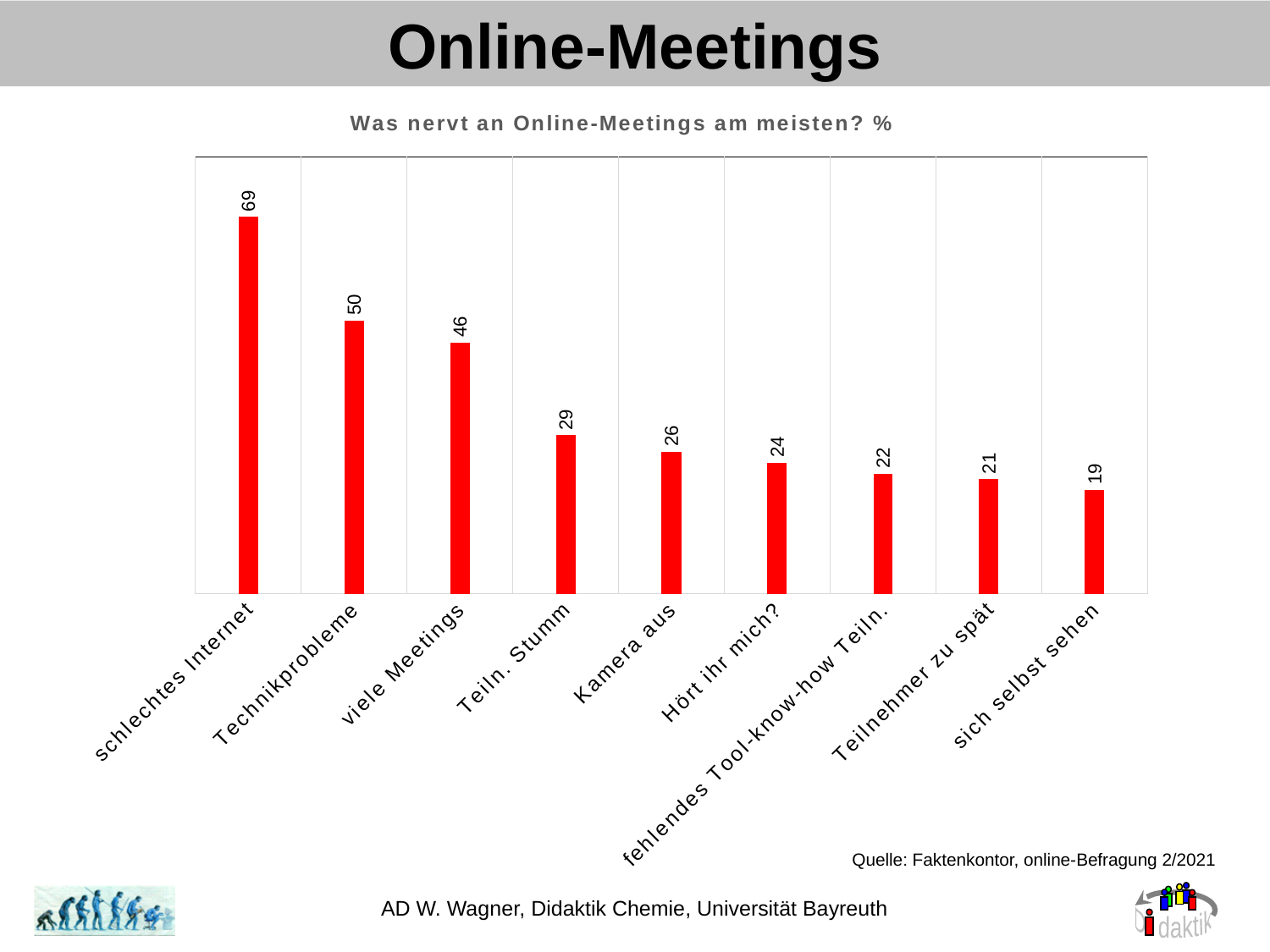
What is the difference between the values for "schlechtes Internet" and "sich selbst sehen"? 50 Which category has the highest value? schlechtes Internet What is the value for "Kamera aus"? 26 What is the difference between the values for "Technikprobleme" and "viele Meetings"? 4 What is the value for "schlechtes Internet"? 69 What is the value for "fehlendes Tool-know-how Teiln."? 22 What is the title of the chart? Was nervt an Online-Meetings am meisten? % Which is larger, the value for "Teiln. Stumm" or the value for "Hört ihr mich?"? Teiln. Stumm Which category has the lowest value? sich selbst sehen Do the values rise or fall from left to right along the x axis? fall What kind of chart is shown on the slide? bar chart How many categories are shown in the chart? 9